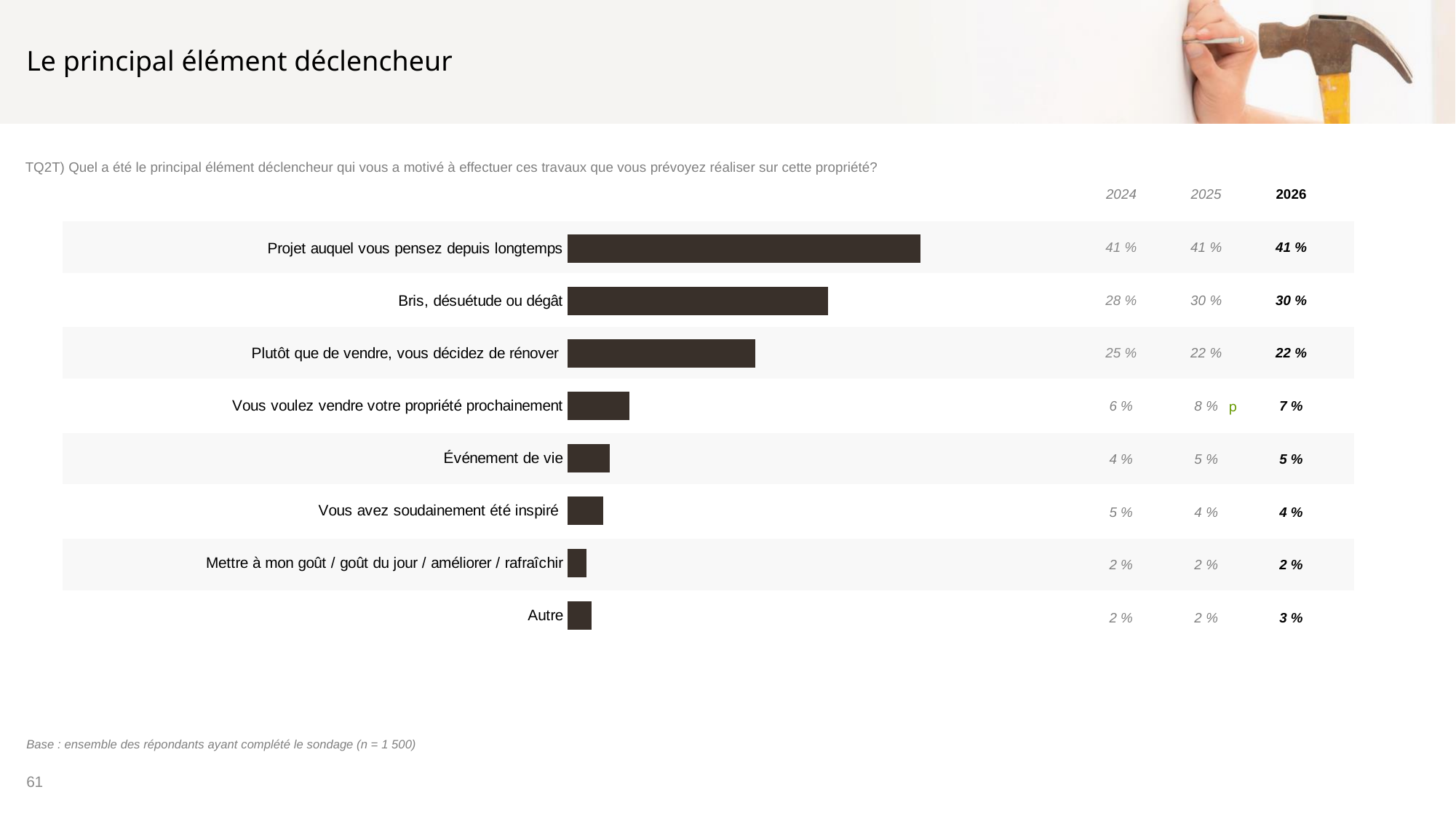
What is the 2025 value for "Vous voulez vendre votre propriété prochainement"? 8 % Which category has the longest bar in the chart? Projet auquel vous pensez depuis longtemps What kind of chart is shown on the slide? bar chart What is the 2026 value for "Autre"? 3 % Which has the larger 2024 value: "Événement de vie" or "Vous avez soudainement été inspiré"? Vous avez soudainement été inspiré Which has the larger 2026 value: "Événement de vie" or "Vous avez soudainement été inspiré"? Événement de vie Which years are shown as columns in the table next to the chart? 2024, 2025, 2026 What is the 2026 value for "Bris, désuétude ou dégât"? 30 % What is the title of the slide? Le principal élément déclencheur What is the difference between the 2026 values for "Projet auquel vous pensez depuis longtemps" and "Bris, désuétude ou dégât"? 11 % What is the 2024 value for "Plutôt que de vendre, vous décidez de rénover"? 25 % How many categories are plotted in the bar chart? 8